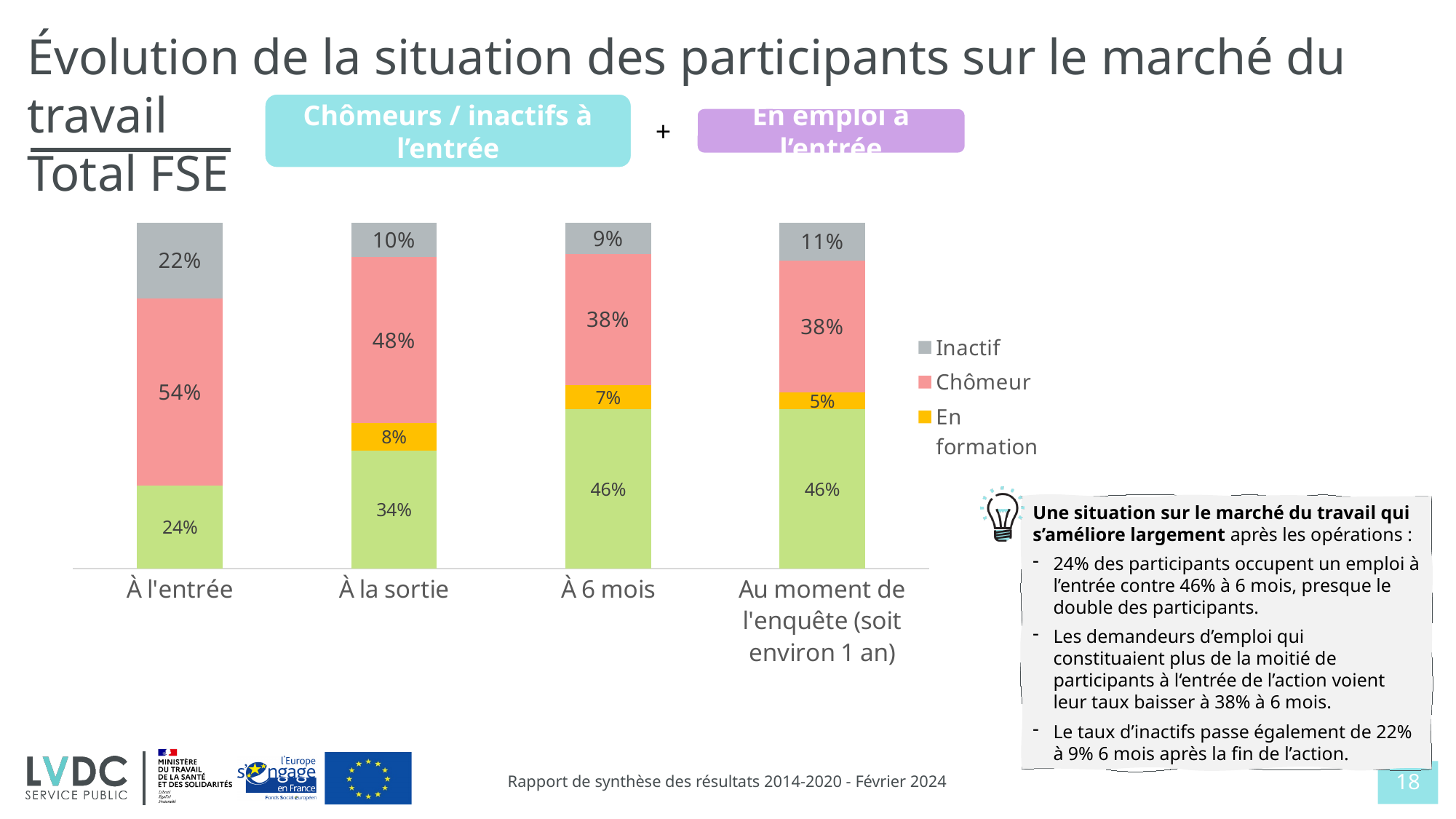
What is the Chômeur value at Au moment de l'enquête (soit environ 1 an)? 38% Does the Chômeur share rise or fall from À l'entrée to À 6 mois? Fall At which time point is the Chômeur share highest? À l'entrée What is the En formation value at À 6 mois? 7% At which time point is the Inactif share lowest? À 6 mois What is the Inactif value for À la sortie? 10% What is the difference between the Chômeur share at À l'entrée and at À 6 mois? 16 percentage points How many series does the legend list? 3 What kind of chart is shown? Stacked bar chart How many time points are shown on the x axis? 4 Which is larger, the En formation share at À la sortie or at Au moment de l'enquête? À la sortie What share of participants were Chômeur at À l'entrée? 54%